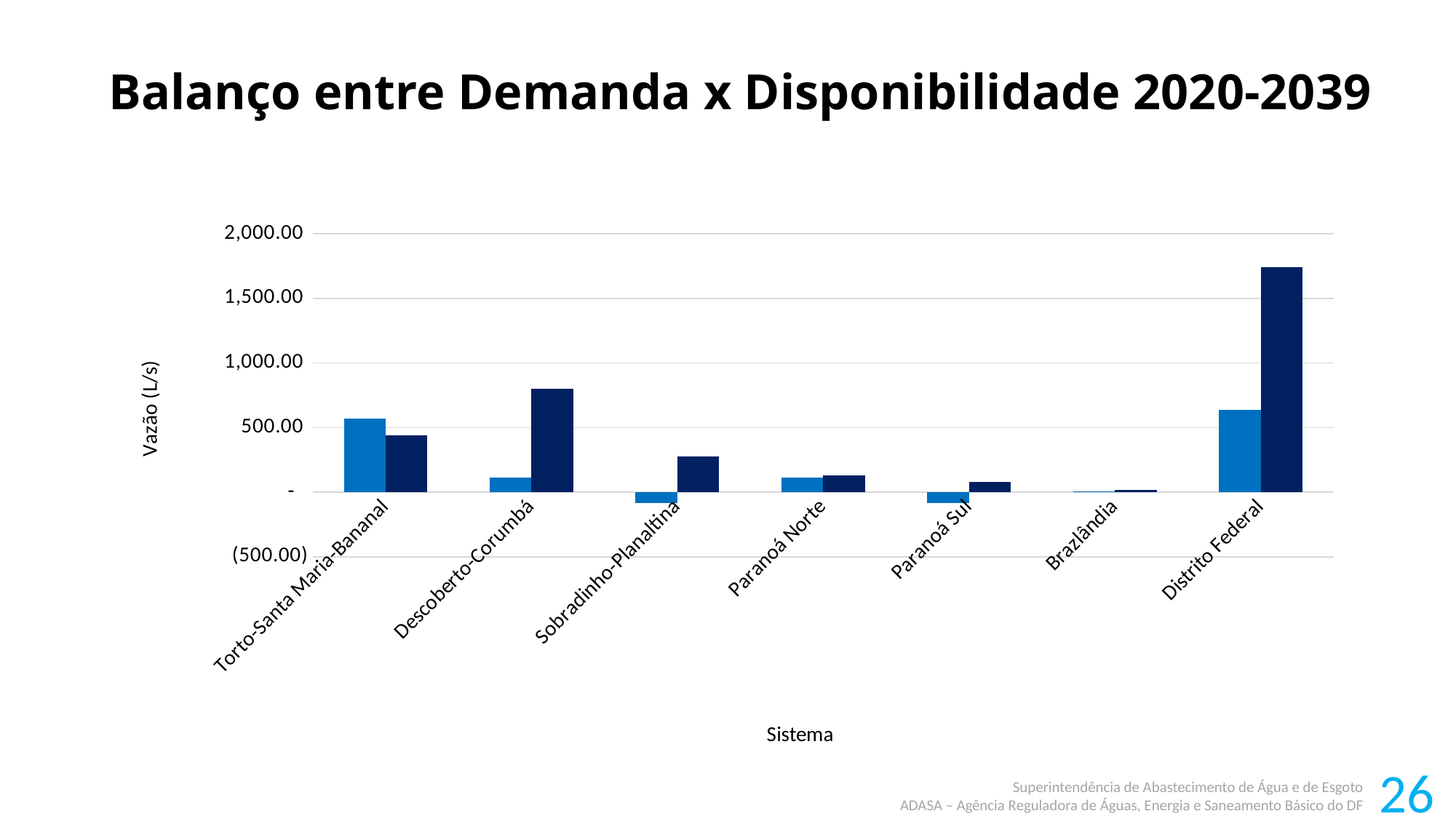
Is the light blue bar for Sobradinho-Planaltina greater or less than zero? less For Torto-Santa Maria-Bananal, which bar is taller, the light blue one or the dark blue one? the light blue one What is the label of the vertical axis of the chart? Vazão (L/s) Is the dark blue bar for Distrito Federal greater or less than 1,500.00? greater For Descoberto-Corumbá, which bar is taller, the light blue one or the dark blue one? the dark blue one What kind of chart is shown on the slide? bar chart Which system has the tallest light blue bar? Distrito Federal What is the title of the chart slide? Balanço entre Demanda x Disponibilidade 2020-2039 Is the dark blue bar for Descoberto-Corumbá greater or less than 500.00? greater How many systems (categories) are shown on the x axis of the chart? 7 Which system has the tallest dark blue bar? Distrito Federal